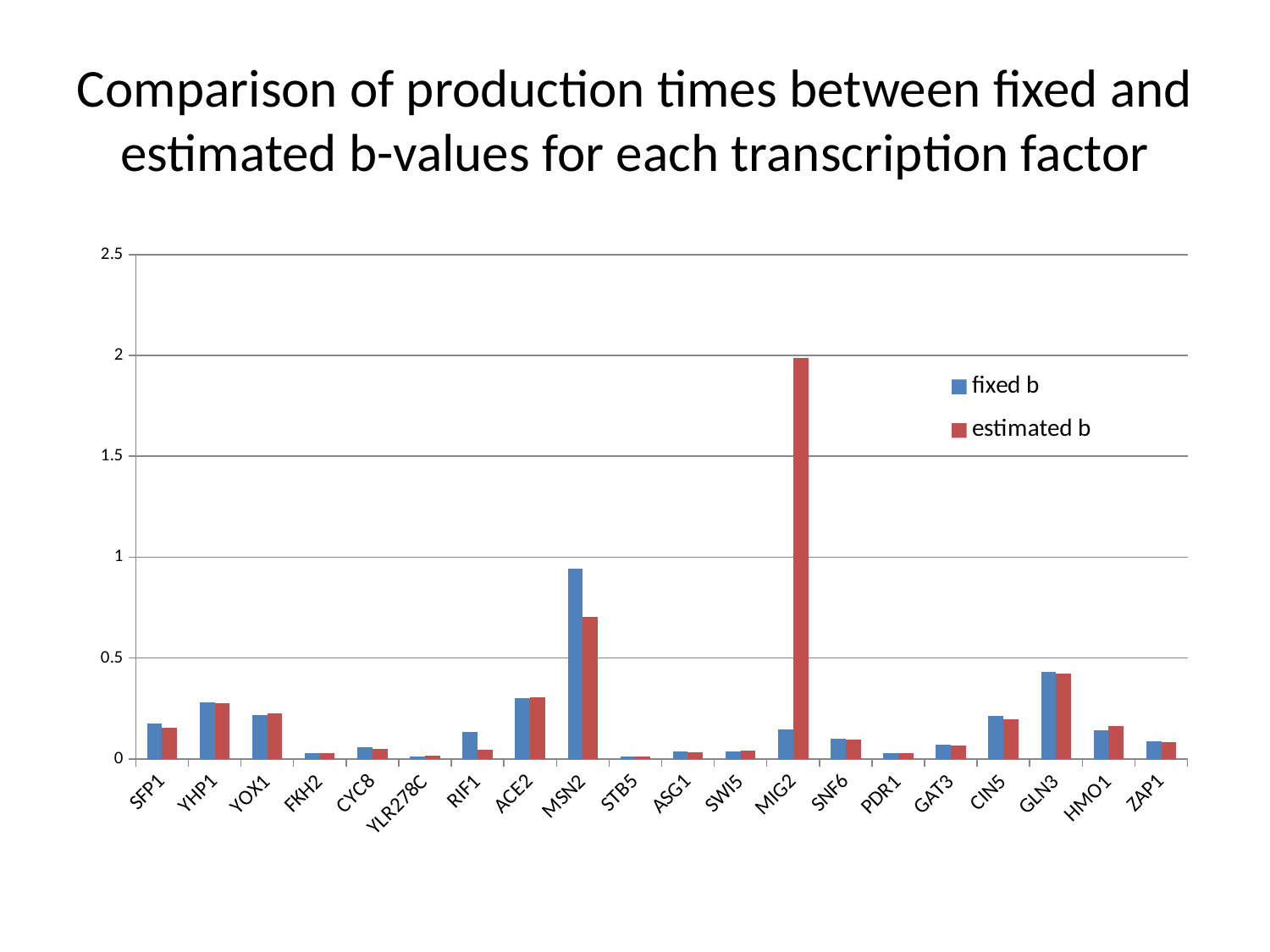
What kind of chart is shown on the slide? bar chart Which transcription factor has the highest fixed b value? MSN2 For MSN2, which is larger: the fixed b value or the estimated b value? fixed b Is the fixed b value for MSN2 greater or less than 1? less Is the estimated b value for MSN2 greater or less than 0.5? greater How many series does the legend list? 2 For MIG2, which is larger: the fixed b value or the estimated b value? estimated b How many transcription factors are shown on the x axis? 20 Is the fixed b value for MIG2 greater or less than 0.5? less Which colour represents the estimated b series in the legend? red Which transcription factor has the highest estimated b value? MIG2